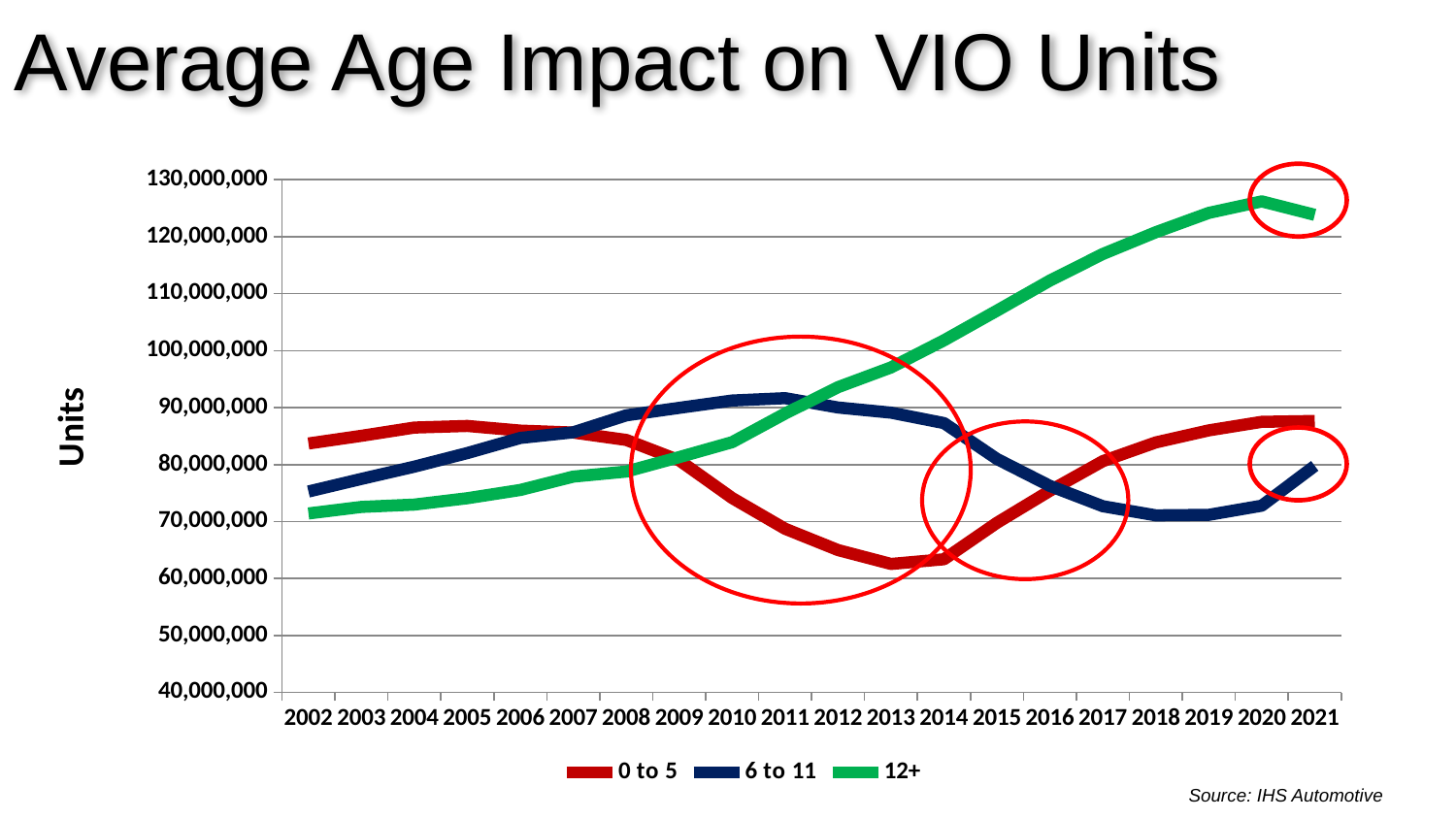
Which series has the highest value in 2021? 12+ What kind of chart is shown on the slide? line chart Is the value for 0 to 5 in 2013 greater or less than 70,000,000? less Which series has the lowest value in 2021? 6 to 11 How many series does the legend list? 3 Is the value for 0 to 5 in 2020 greater or less than 80,000,000? greater Is the value for 12+ in 2021 greater or less than 120,000,000? greater Does the 12+ series rise or fall from 2008 to 2020? rise What is the label on the y axis? Units How many years are shown on the x axis? 20 In 2013, which series has the larger value, 12+ or 0 to 5? 12+